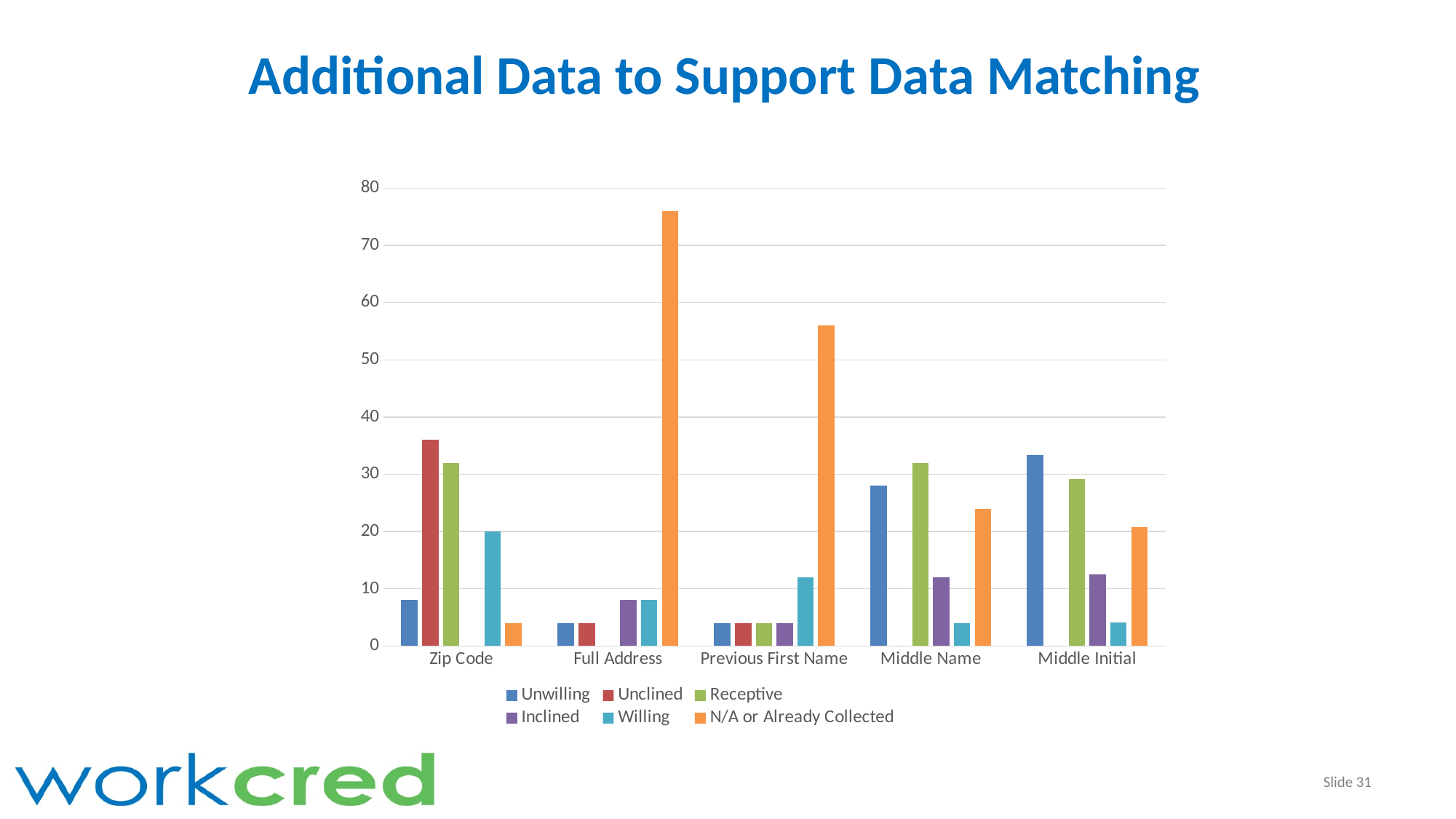
Is the Unclined value for Zip Code greater or less than 30? greater Is the Willing value for Zip Code greater or less than 10? greater Is the Unwilling value for Middle Initial greater or less than 30? greater What is the title of the chart? Additional Data to Support Data Matching What kind of chart is shown on the slide? bar chart For Zip Code, which is larger: the Unclined bar or the Receptive bar? Unclined Which category has the lowest N/A or Already Collected bar? Zip Code Which has the larger N/A or Already Collected value: Previous First Name or Middle Name? Previous First Name Which category has the highest N/A or Already Collected bar? Full Address How many categories are shown on the x axis? 5 How many series does the legend list? 6